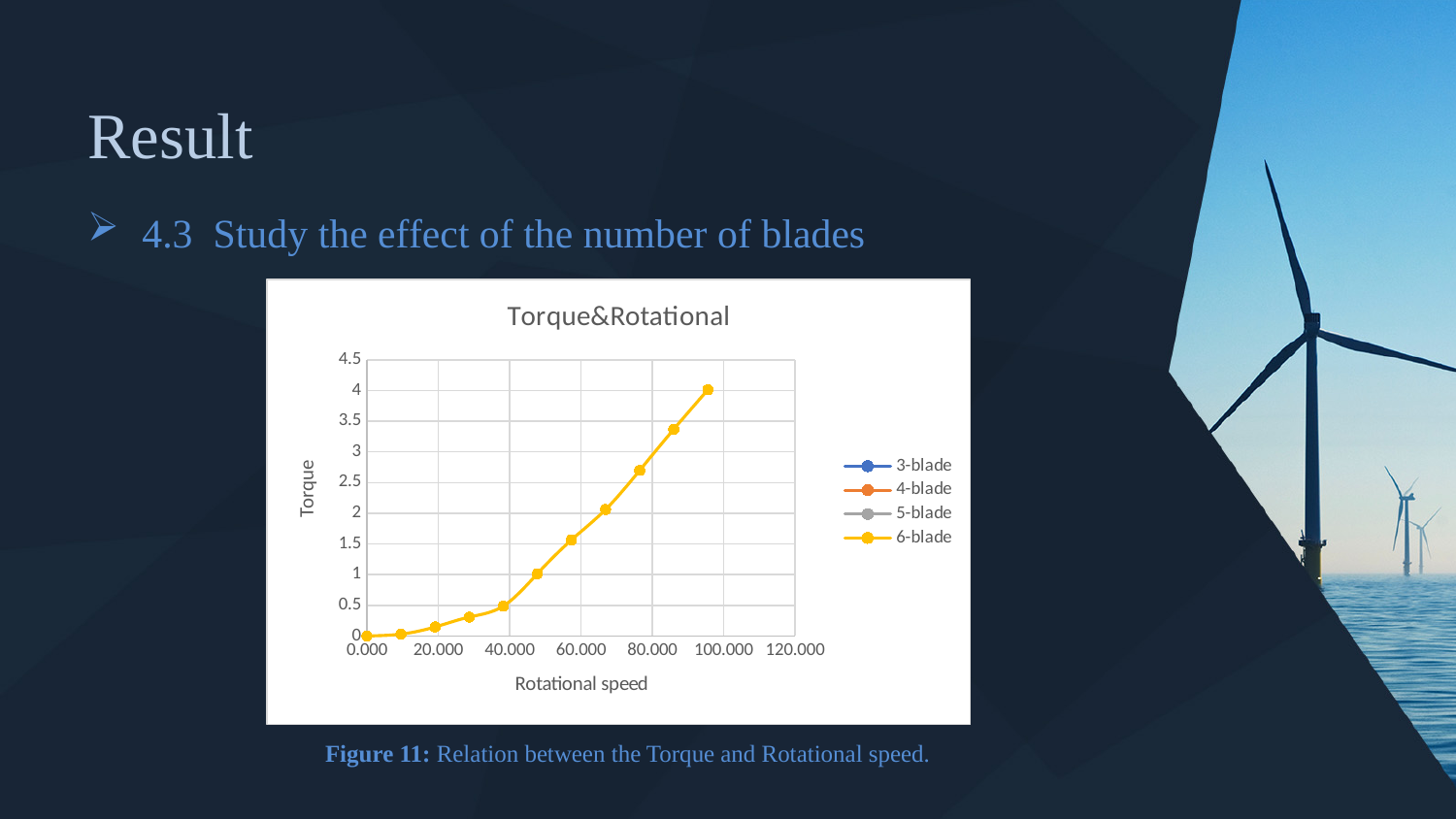
Is the torque of the rightmost plotted point greater or less than 3.5? greater Is the torque of the leftmost plotted point (at rotational speed 0.000) greater or less than 0.5? less What kind of chart is shown on the slide? line chart Which series is drawn in yellow in the legend? 6-blade Does the torque rise or fall as rotational speed increases along the x axis? rises Which plotted point has the highest torque: the one at rotational speed about 40.000 or the one at about 100.000? the one at about 100.000 Is the torque at a rotational speed of about 80.000 greater or less than 2? greater How many series does the chart's legend list? 4 What is the title of the chart? Torque&Rotational How many data points are plotted on the visible line? 11 What is the label of the x axis of the chart? Rotational speed